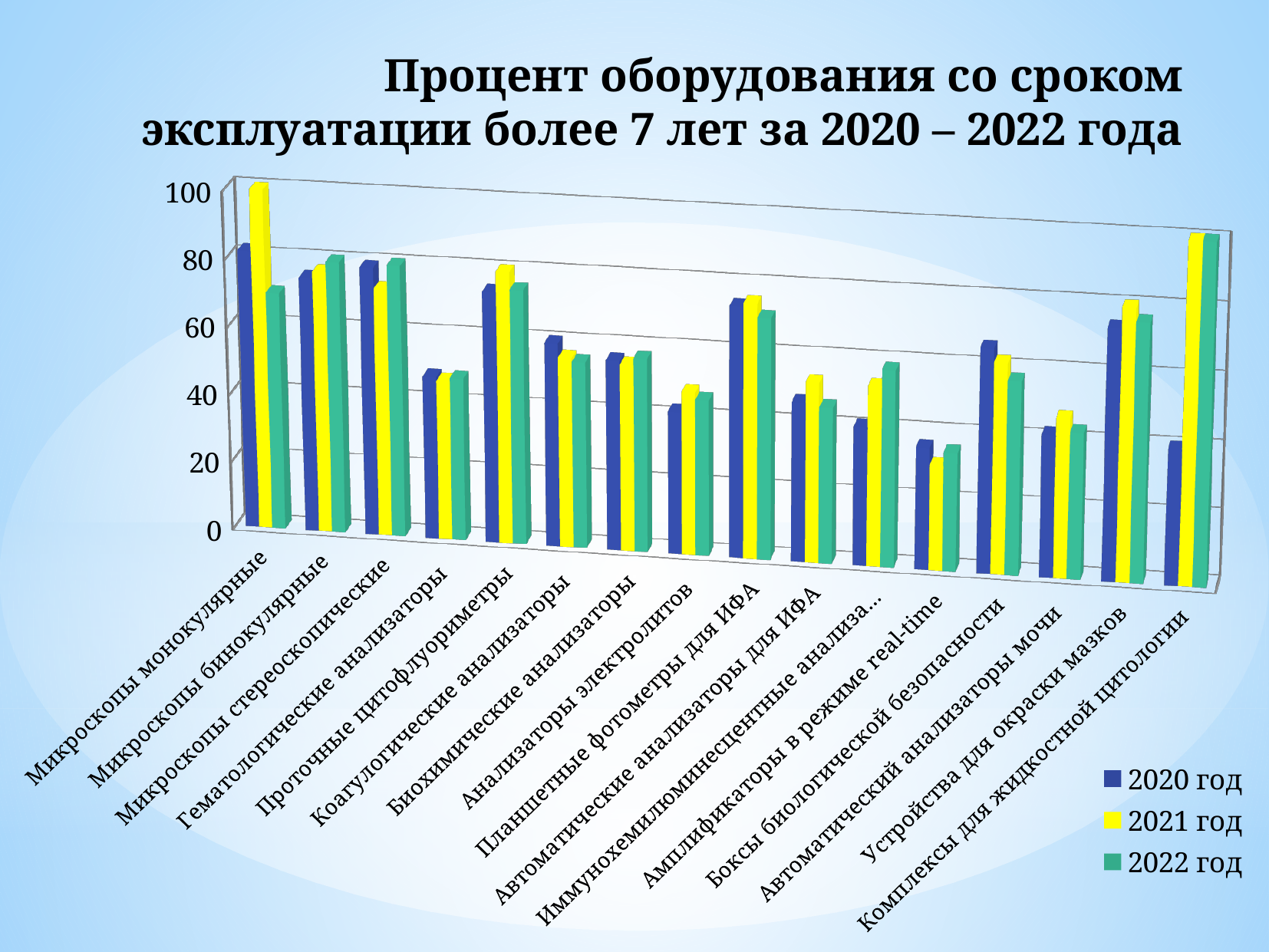
What kind of chart is shown on the slide? bar chart Is the 2021 value for Амплификаторы в режиме real-time greater or less than 40? less Which category has the lowest 2021 value? Амплификаторы в режиме real-time What is the title of the chart? Процент оборудования со сроком эксплуатации более 7 лет за 2020 – 2022 года Is the 2021 value for Комплексы для жидкостной цитологии greater or less than 60? greater How many equipment categories are shown on the x axis? 16 For Микроскопы монокулярные, which is larger: the 2021 value or the 2022 value? 2021 Is the 2021 value for Микроскопы монокулярные greater or less than 80? greater How many series does the legend list? 3 Which series are listed in the legend? 2020 год, 2021 год, 2022 год